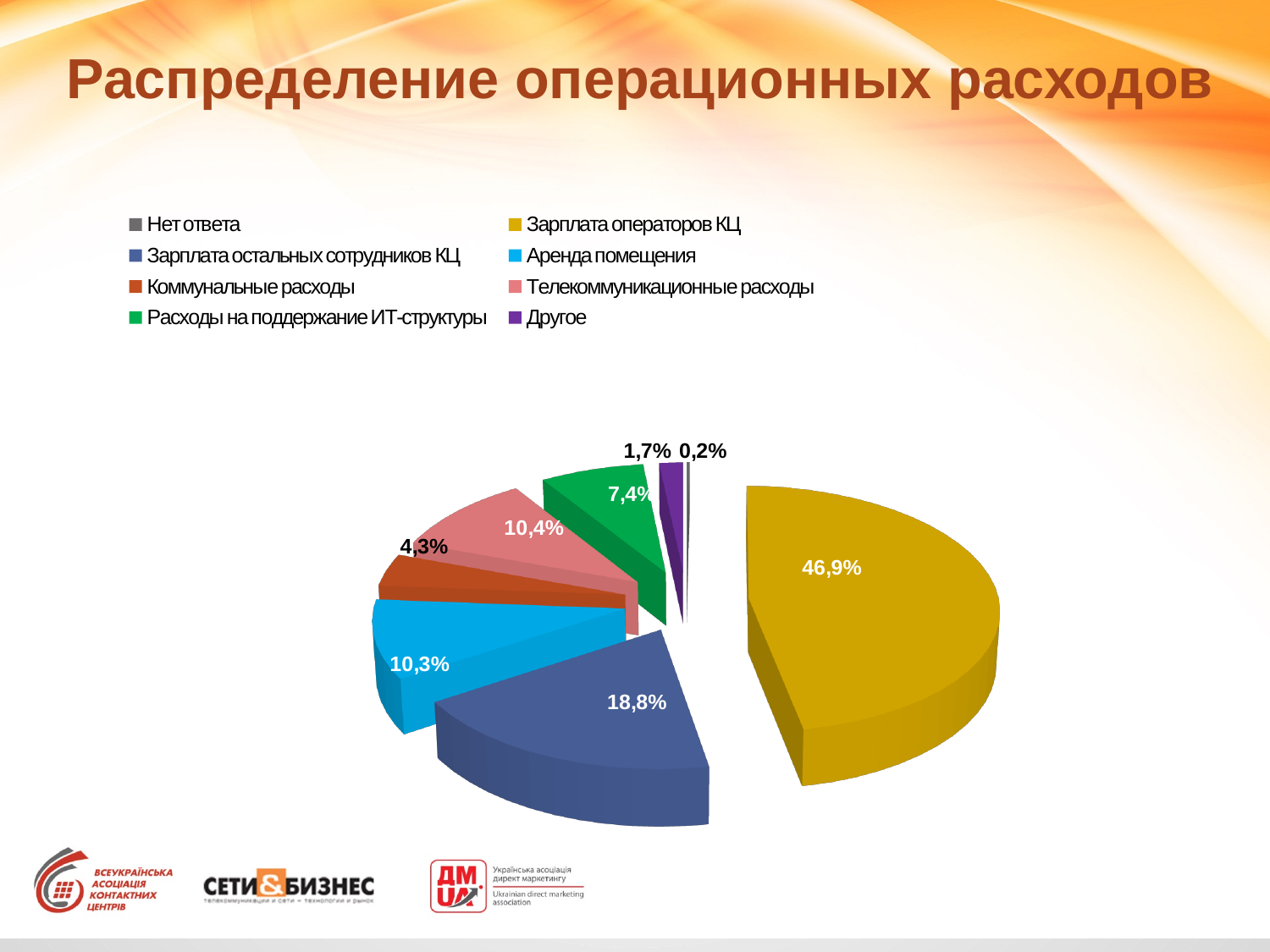
What share of operating expenses is Расходы на поддержание ИТ-структуры? 7,4% Which is larger: the share for Расходы на поддержание ИТ-структуры or for Коммунальные расходы? Расходы на поддержание ИТ-структуры What share of operating expenses is Зарплата операторов КЦ? 46,9% What share of operating expenses is Аренда помещения? 10,3% Which category has the largest share of operating expenses? Зарплата операторов КЦ How many categories does the legend list? 8 What share of operating expenses is Телекоммуникационные расходы? 10,4% What type of chart is shown on the slide? Pie chart What share of operating expenses is Зарплата остальных сотрудников КЦ? 18,8% What share of operating expenses is Коммунальные расходы? 4,3% Which category has the smallest share of operating expenses? Нет ответа What is the difference in percentage points between Зарплата операторов КЦ and Зарплата остальных сотрудников КЦ? 28,1